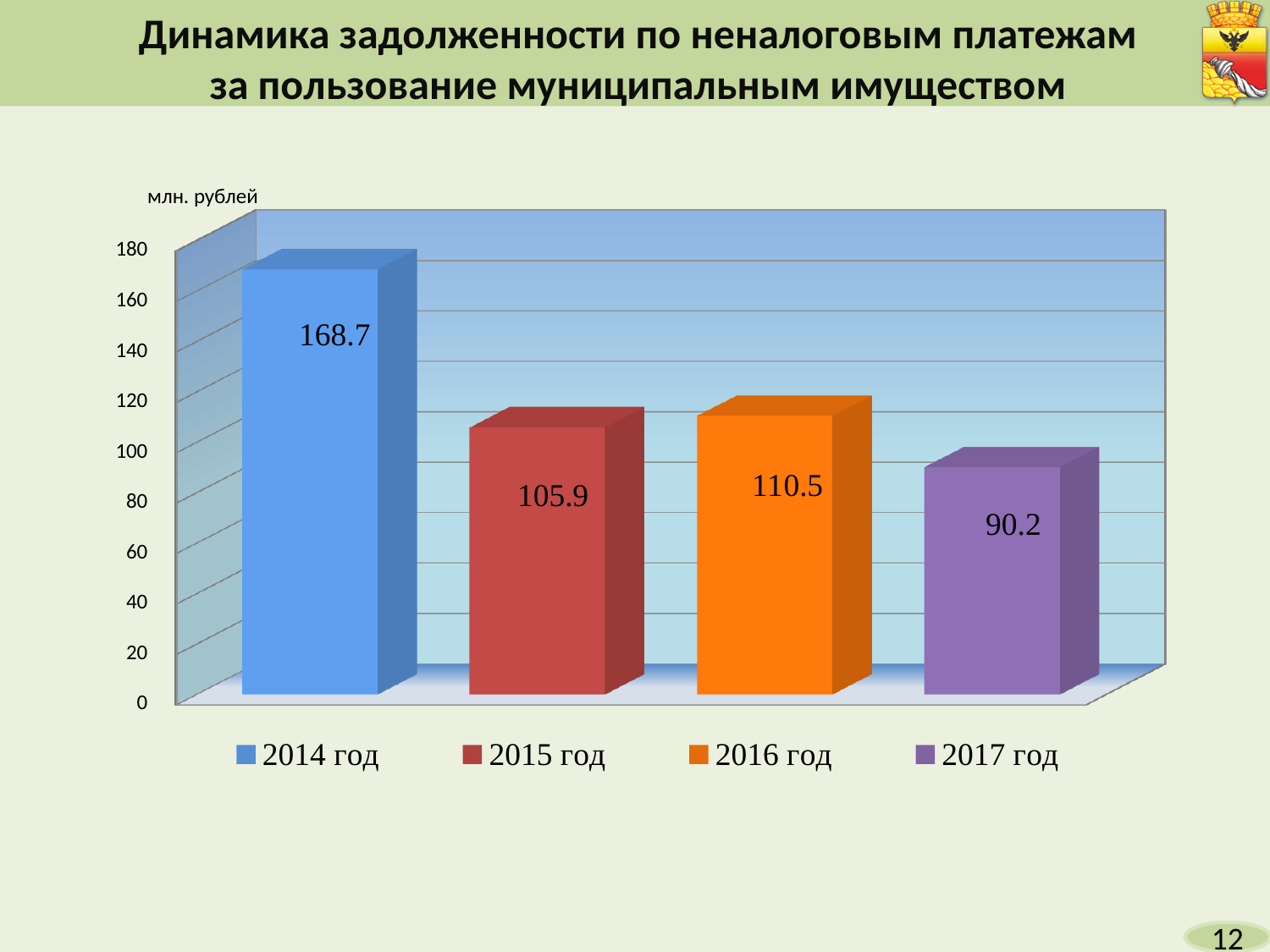
How many bars are shown in the chart? 4 What is the value for 2015 год? 105.9 Which is larger, the value for 2015 год or 2016 год? 2016 год What kind of chart is shown on the slide? bar chart What is the value for 2017 год? 90.2 What is the difference between the values for 2014 год and 2017 год? 78.5 What is the value for 2014 год? 168.7 What unit is shown on the chart's axis label? млн. рублей Is the value for 2017 год greater or less than 100? less Which year has the highest value? 2014 год What is the value for 2016 год? 110.5 Which year has the lowest value? 2017 год